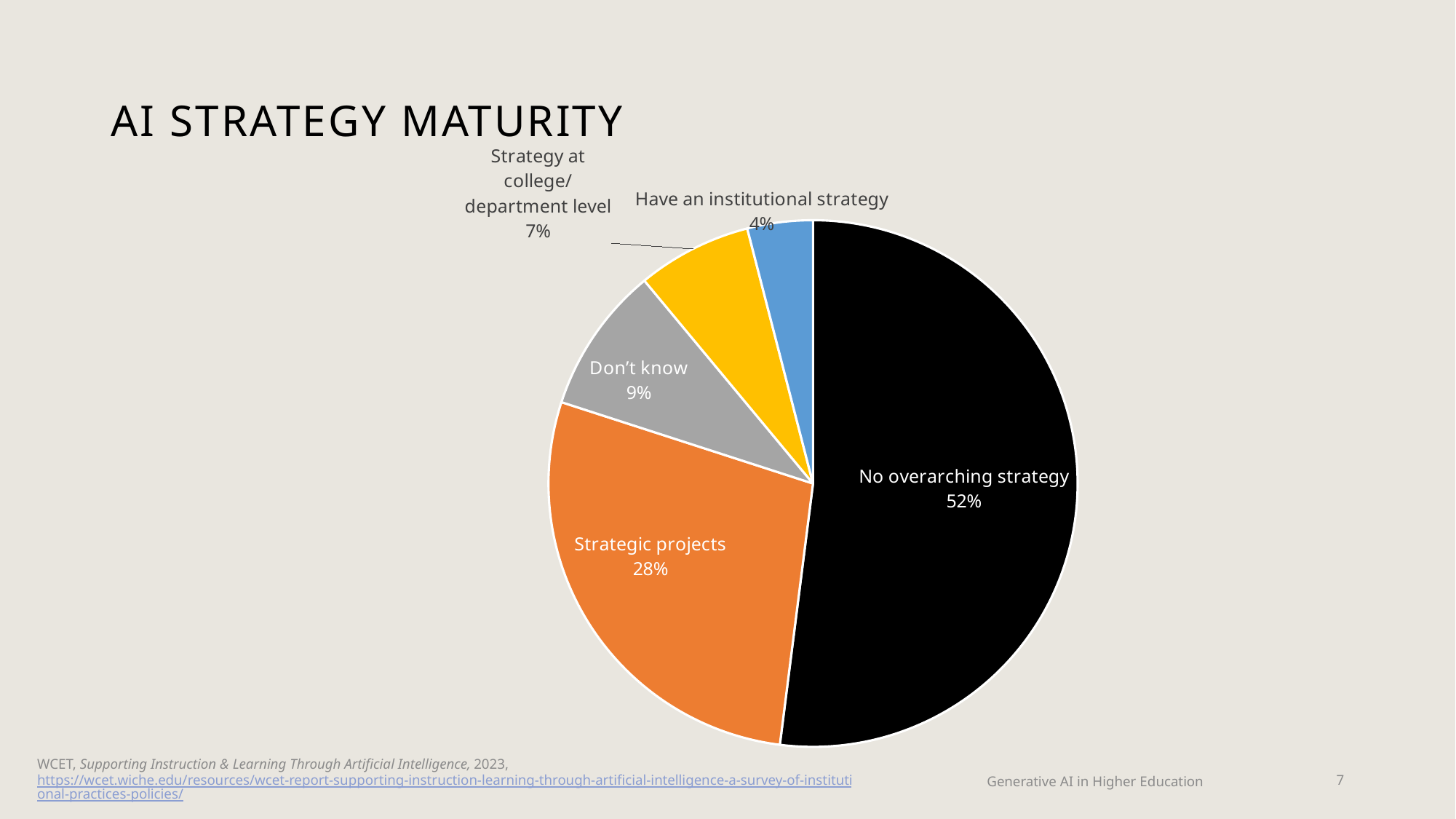
What is the value for "Strategy at college/department level"? 7% Which category has the smallest slice of the pie? Have an institutional strategy Which category has the largest slice of the pie? No overarching strategy What share of the pie is labelled "No overarching strategy"? 52% Which is larger, "Don't know" or "Strategy at college/department level"? Don't know What is the value for "Strategic projects"? 28% What is the difference between the "No overarching strategy" and "Strategic projects" values? 24% What is the value for "Have an institutional strategy"? 4% What kind of chart is shown on the slide? pie chart What is the value for "Don't know"? 9% What is the title of the slide containing the pie chart? AI STRATEGY MATURITY How many slices does the pie chart have? 5